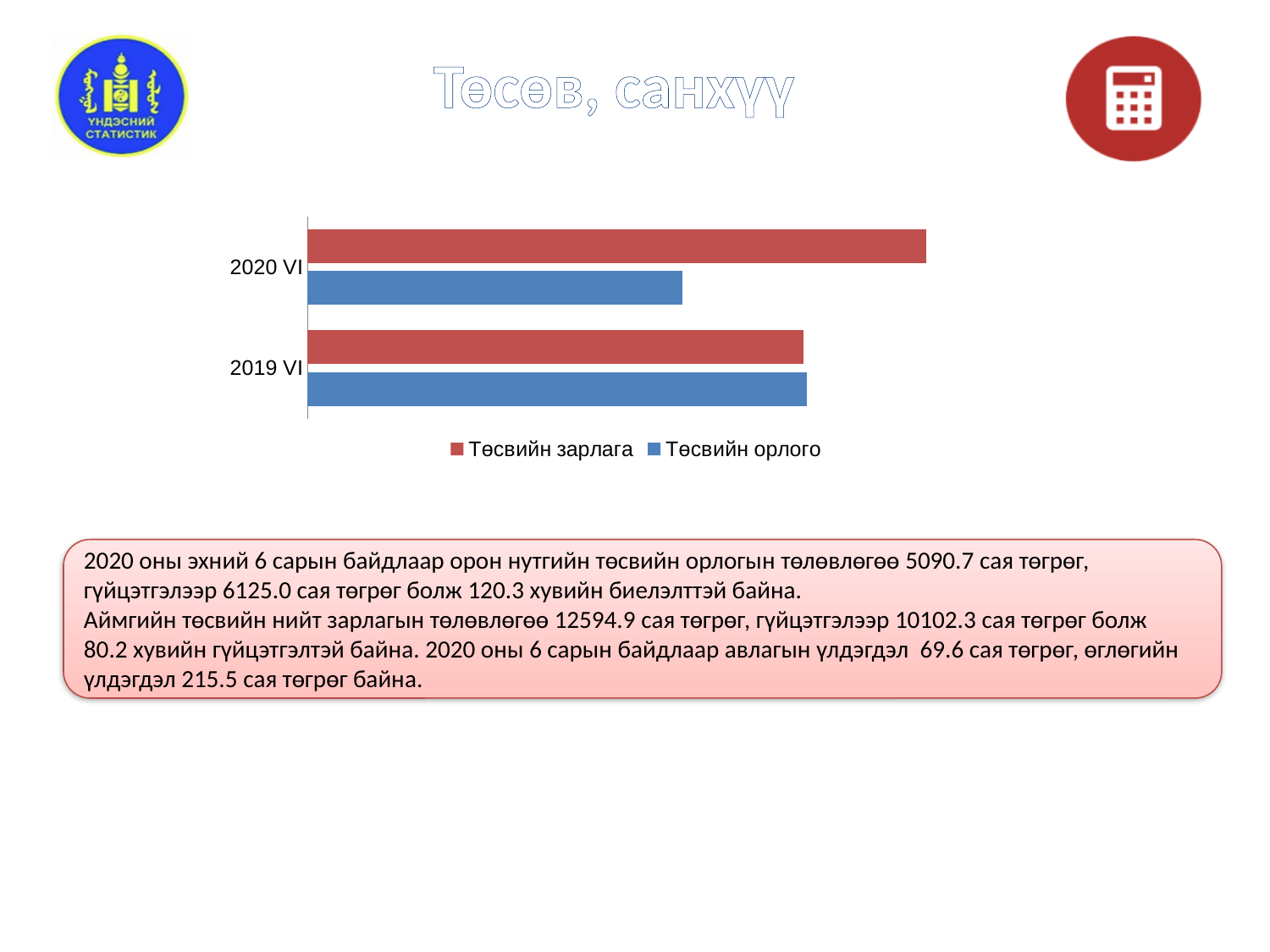
Which period has the highest Төсвийн зарлага value? 2020 VI Which period has the lowest Төсвийн орлого value? 2020 VI What kind of chart is shown on the slide? bar chart Which period has the larger Төсвийн зарлага bar: 2019 VI or 2020 VI? 2020 VI How many series does the chart's legend list? 2 For 2020 VI, which is larger: Төсвийн зарлага or Төсвийн орлого? Төсвийн зарлага Which period has the larger Төсвийн орлого bar: 2019 VI or 2020 VI? 2019 VI How many categories are shown on the chart's vertical axis? 2 Does Төсвийн орлого rise or fall from 2019 VI to 2020 VI? fall What are the two series named in the chart's legend? Төсвийн зарлага and Төсвийн орлого Does Төсвийн зарлага rise or fall from 2019 VI to 2020 VI? rise Which colour represents Төсвийн орлого in the chart? blue